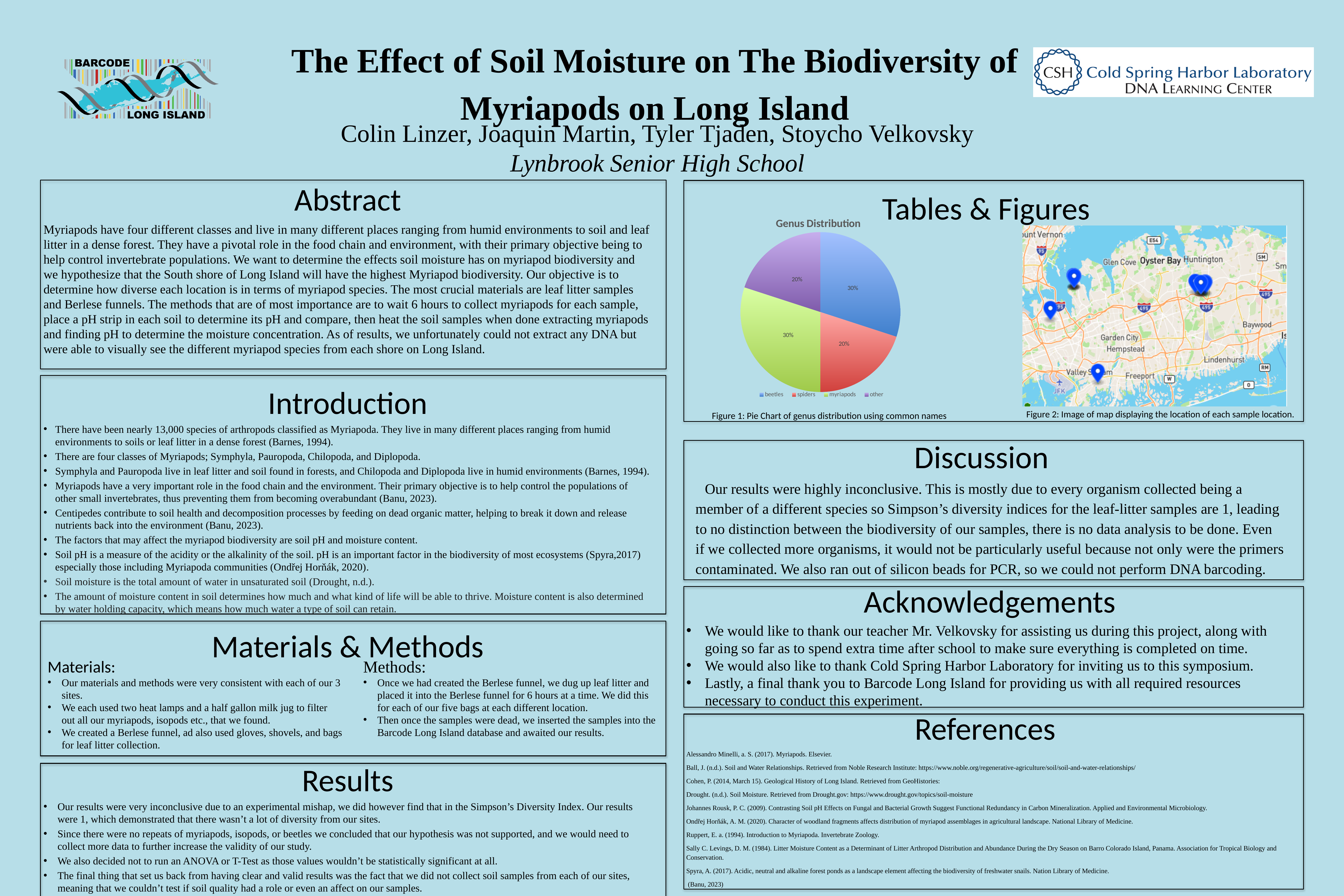
What is the title of the pie chart in Figure 1? Genus Distribution In the Genus Distribution pie chart, which is larger: the share for beetles or the share for spiders? beetles In the Genus Distribution pie chart, what is the difference between the share for beetles and the share for spiders? 10% In the Genus Distribution pie chart, what share of the pie do myriapods make up? 30% How many categories does the Genus Distribution pie chart show? 4 In the Genus Distribution pie chart, which is larger: the share for myriapods or the share for other? myriapods In the Genus Distribution pie chart, what share of the pie do spiders make up? 20% In the Genus Distribution pie chart, which category is shown in green? myriapods What type of chart is shown in Figure 1? pie chart In the Genus Distribution pie chart, what is the difference between the share for myriapods and the share for other? 10% In the Genus Distribution pie chart, what share of the pie do beetles make up? 30%